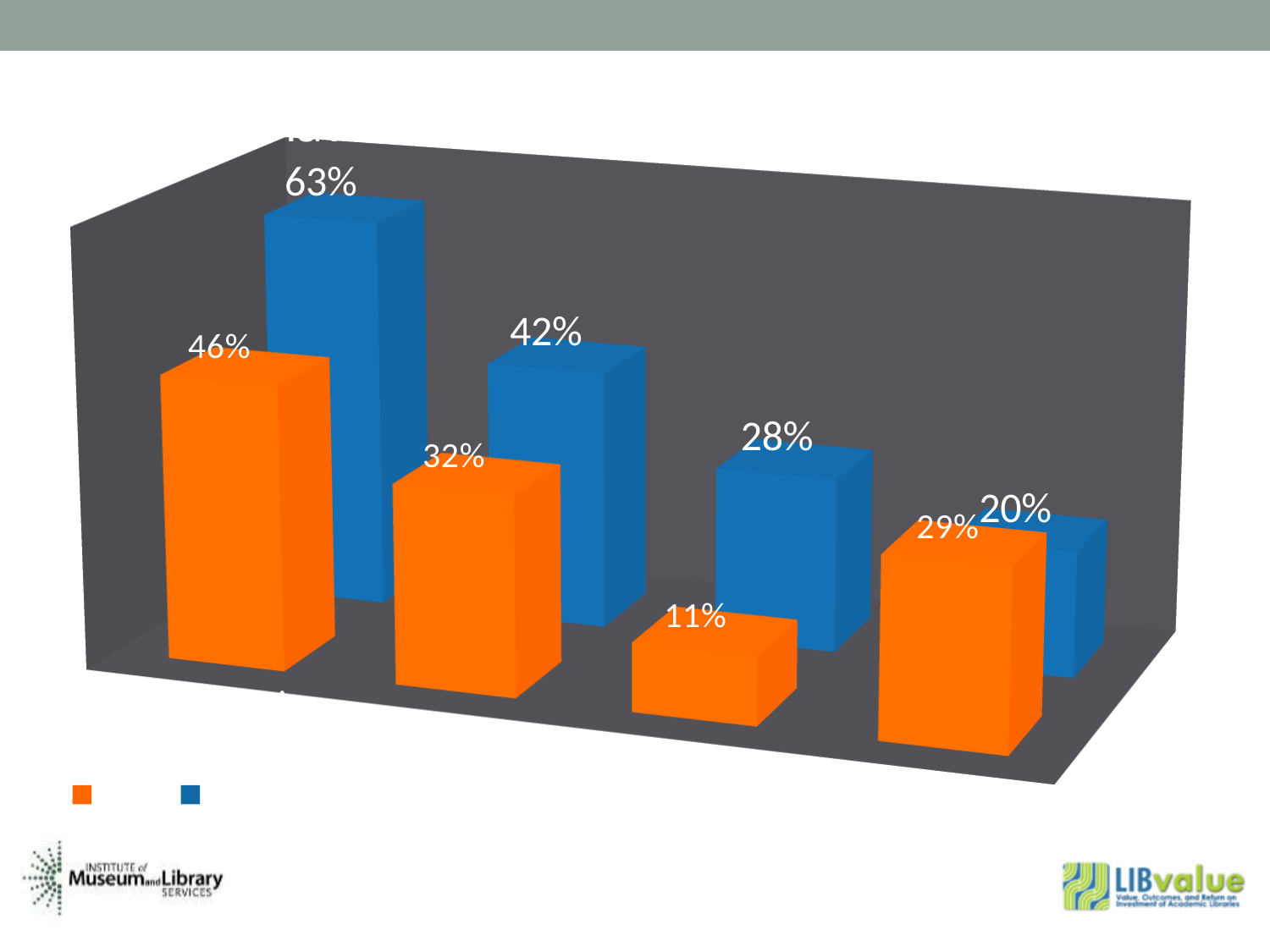
How many categories (groups of bars) are plotted in the chart? 4 Which bar has the highest value in the chart? The blue bar in the first group, 63% What is the value of the blue bar in the first (leftmost) group? 63% Do the values of the blue series rise or fall from left to right across the groups? Fall What is the value of the blue bar in the third group from the left? 28% Which bar has the lowest value in the chart? The orange bar in the third group, 11% In the first (leftmost) group, how much larger is the blue bar than the orange bar? 17 percentage points In the fourth (rightmost) group, which bar is larger, the orange or the blue? Orange What kind of chart is shown on the slide? Bar chart What is the value of the orange bar in the fourth (rightmost) group? 29% What is the value of the orange bar in the first (leftmost) group? 46% How many series does the legend list? 2